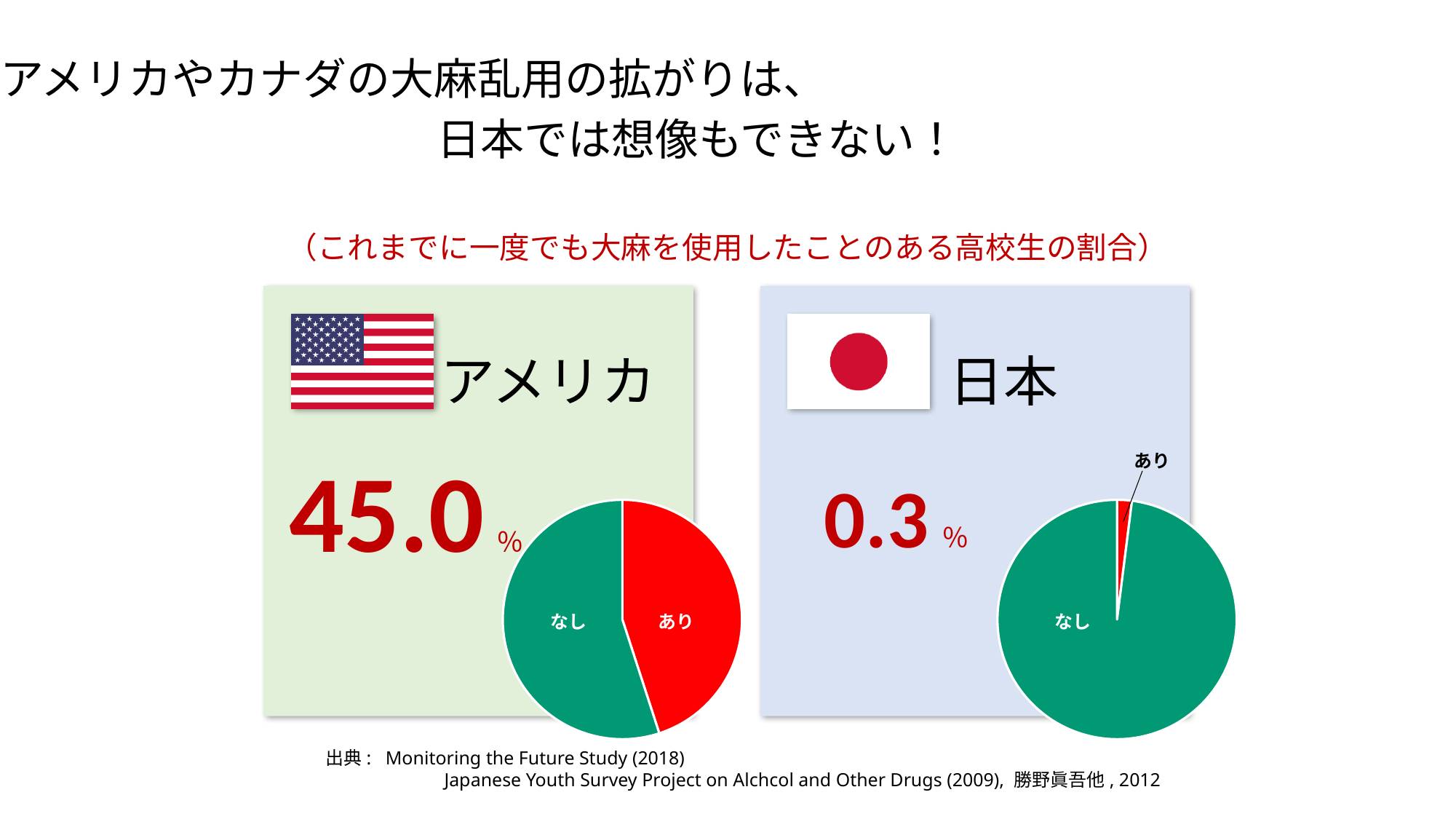
What is the difference between the あり percentage for アメリカ and for 日本? 44.7% In the アメリカ chart, what percentage of high school students have used cannabis (あり)? 45.0% How many slices does the アメリカ pie chart have? 2 What kind of chart is shown for 日本? pie chart How many slices does the 日本 pie chart have? 2 Which slice is the smallest in the 日本 pie chart? あり What colour is the なし slice in both pie charts? green What colour is the あり slice in both pie charts? red Which slice is larger in the アメリカ pie chart, あり or なし? あり Which country has the higher あり percentage, アメリカ or 日本? アメリカ In the 日本 chart, what percentage of high school students have used cannabis (あり)? 0.3% What kind of chart is shown for アメリカ? pie chart